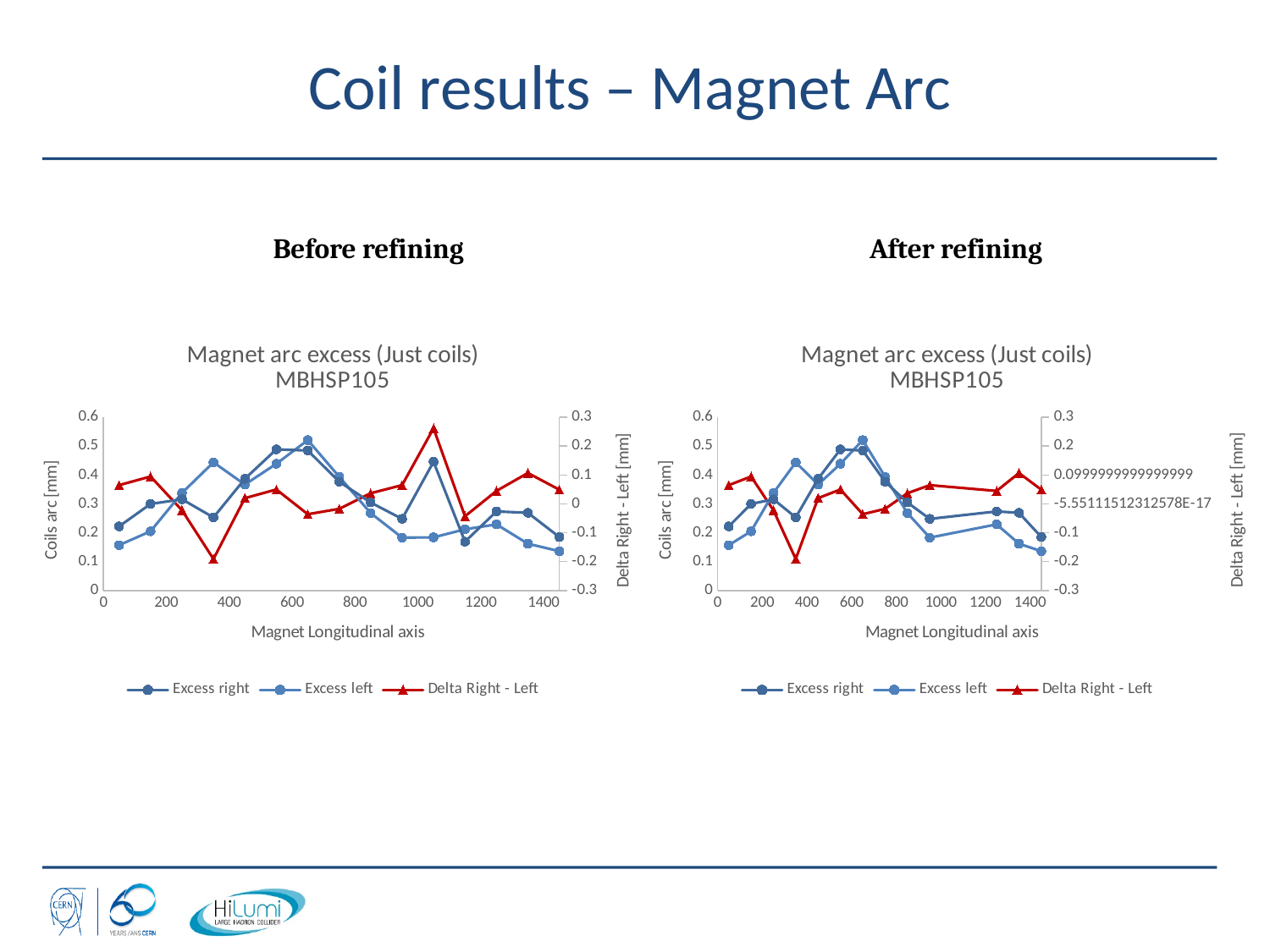
What kind of chart is the 'Before refining' chart? line chart In the 'Before refining' chart, is the Excess right value at x = 550 greater or less than 0.4? greater How many series does the legend of the 'After refining' chart list? 3 In the 'Before refining' chart, which series is drawn in red with triangle markers? Delta Right - Left In the 'After refining' chart, is the Delta Right - Left value at x = 350 greater or less than -0.1 on the right axis? less What is the x-axis label of the 'After refining' chart? Magnet Longitudinal axis In the 'Before refining' chart, is the Excess left value at x = 1450 greater or less than 0.2? less In the 'Before refining' chart, at x = 1050, which is larger: Excess left or Excess right? Excess right In the 'Before refining' chart, at which x value does the Delta Right - Left series reach its lowest point? 350